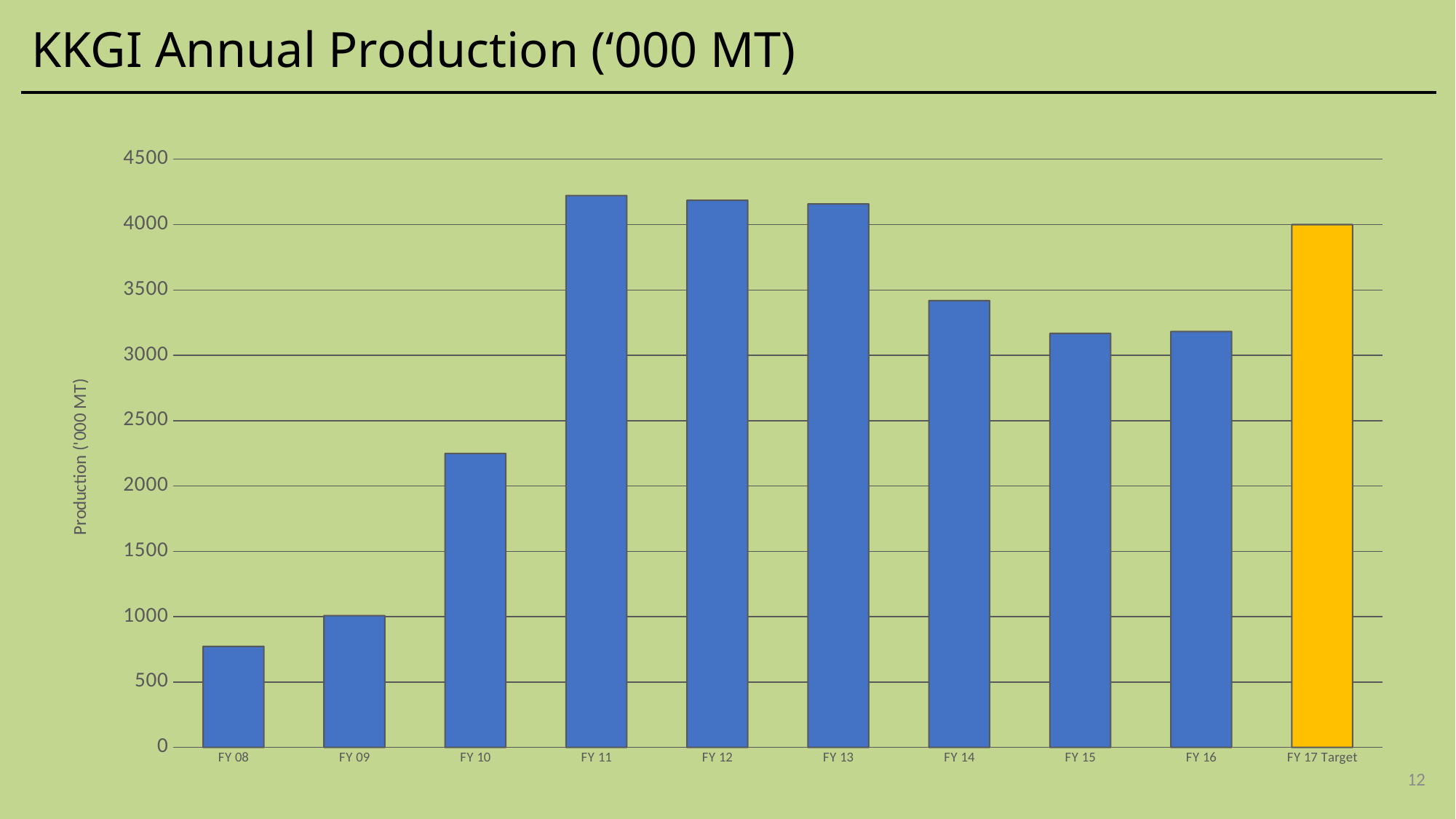
Is the value for FY 10 greater or less than 2000? greater Do the values rise or fall from FY 08 to FY 11? rise Is the value for FY 14 greater or less than 3500? less How many categories (bars) are plotted on the chart? 10 What is the label on the vertical axis? Production ('000 MT) Is the value for FY 08 greater or less than 1000? less What kind of chart is shown on the slide? bar chart What is the value for FY 17 Target? 4000 Do the values rise or fall from FY 13 to FY 15? fall Which is larger, the value for FY 10 or the value for FY 14? FY 14 Which category has the lowest production? FY 08